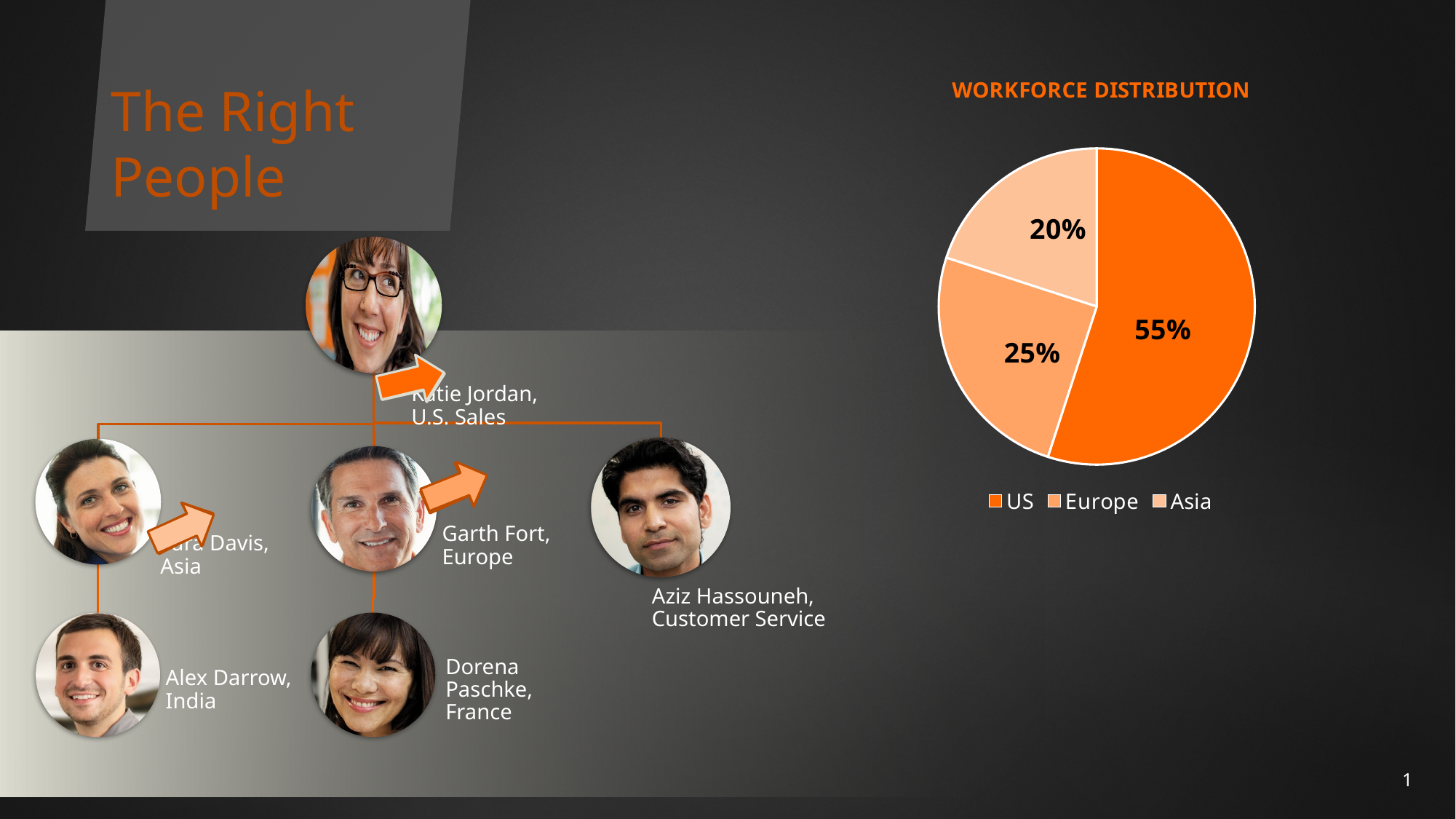
What is the difference in percentage points between the US share and the Europe share? 30 How many slices does the workforce distribution pie chart have? 3 What kind of chart is shown on the slide? pie chart Which region has the smallest share in the workforce distribution pie chart? Asia What share of the workforce is in Europe according to the pie chart? 25% What share of the workforce is in the US according to the pie chart? 55% What share of the workforce is in Asia according to the pie chart? 20% Which region has the largest share in the workforce distribution pie chart? US What is the difference in percentage points between the Europe share and the Asia share? 5 What is the title of the chart on the slide? WORKFORCE DISTRIBUTION How many entries does the legend of the pie chart list? 3 Which has a larger share of the workforce, Europe or Asia? Europe